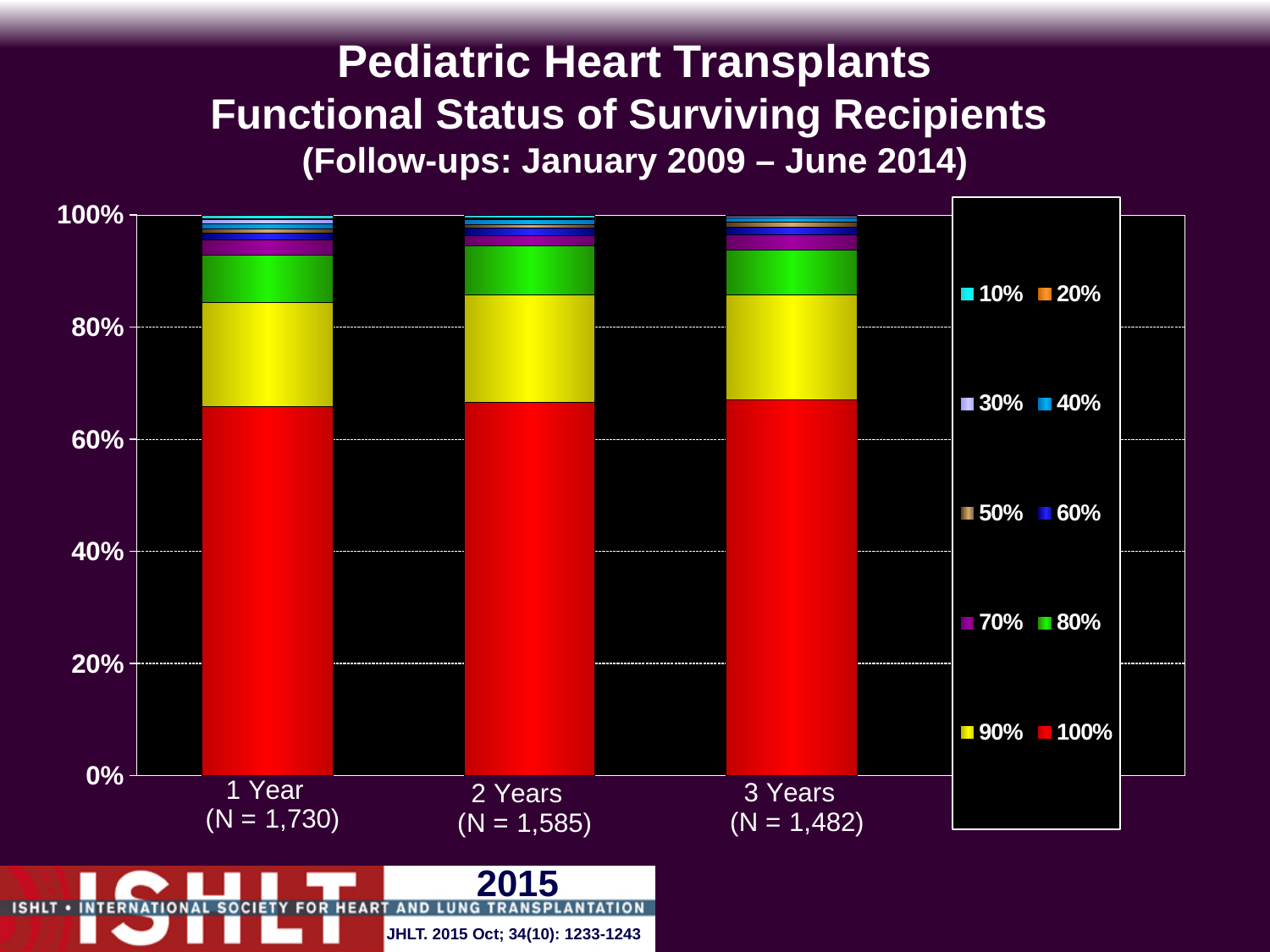
Which category has the larger N, 1 Year or 3 Years? 1 Year How many categories (follow-up time points) are shown on the x axis? 3 What is the difference between the N for 1 Year and the N for 2 Years? 145 Which legend entry is shown in red? 100% What is the N value shown for the 3 Years category? 1,482 What is the N value shown for the 2 Years category? 1,585 Is the share of the 100% functional status segment (red) in the 1 Year bar greater or less than 60%? greater What follow-up period is given in the chart title? January 2009 – June 2014 Is the share of the 100% functional status segment (red) in the 3 Years bar greater or less than 80%? less What kind of chart is shown on the slide? stacked bar chart How many series does the legend list? 10 What is the total height of the stacked bar for 1 Year? 100%